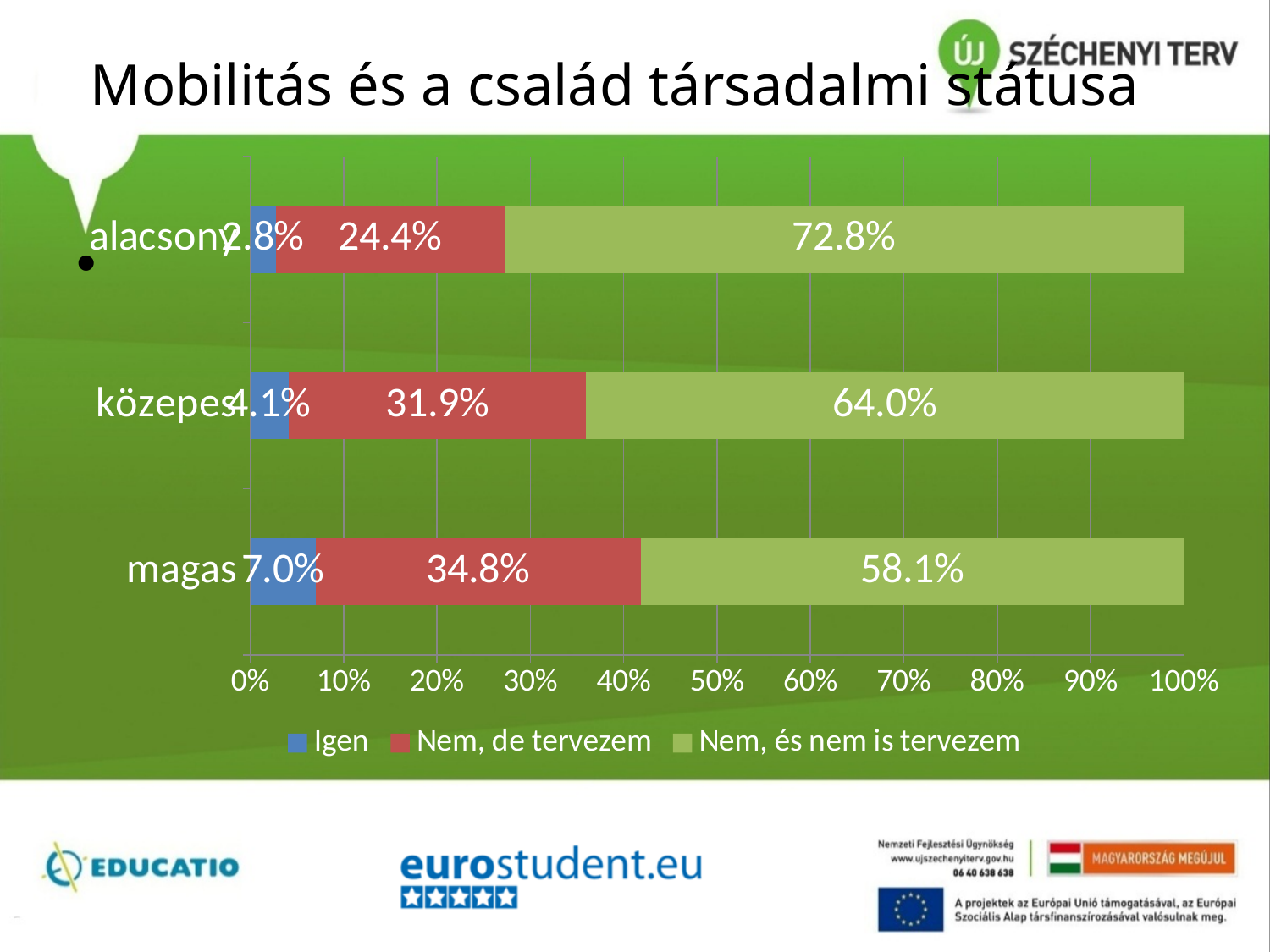
How many series does the legend list? 3 What is the value of "Igen" for the magas category? 7.0% How many categories are shown on the chart? 3 Which is larger: the "Nem, és nem is tervezem" value for közepes or for magas? közepes Which category has the lowest value for "Nem, és nem is tervezem"? magas What is the difference between the "Nem, de tervezem" values for magas and alacsony? 10.4% What is the value of "Nem, de tervezem" for the közepes category? 31.9% What kind of chart is shown on the slide? stacked bar chart Which series is shown in blue in the legend? Igen What is the total of the stacked bar for the közepes category? 100.0% Which category has the highest value for "Igen"? magas What is the value of "Nem, és nem is tervezem" for the alacsony category? 72.8%